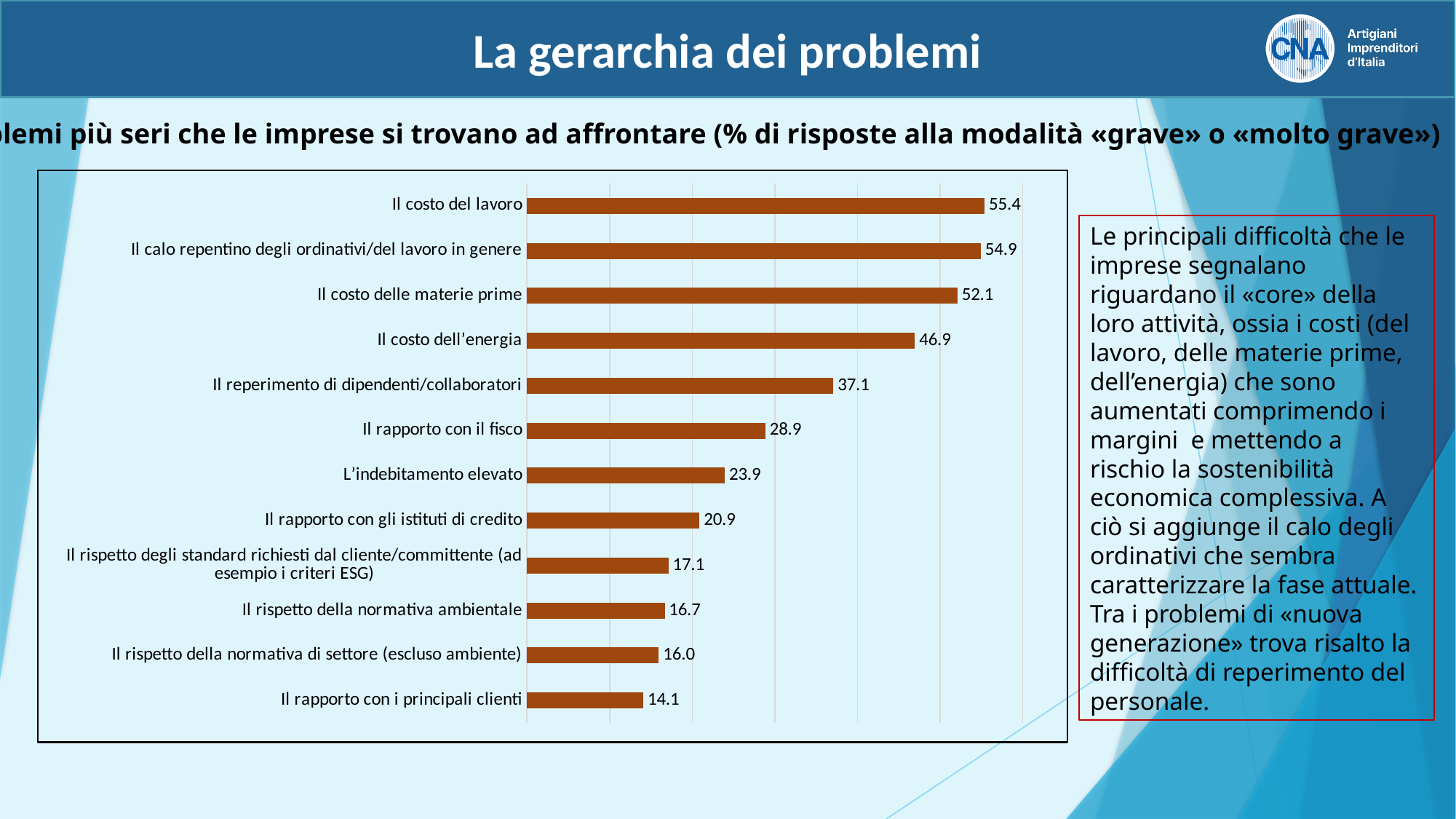
What is the difference between the values for "L'indebitamento elevato" and "Il rapporto con gli istituti di credito"? 3.0 Which is larger, the value for "Il costo dell'energia" or the value for "Il reperimento di dipendenti/collaboratori"? Il costo dell'energia What kind of chart is shown on the slide? Bar chart What is the difference between the values for "Il costo del lavoro" and "Il costo delle materie prime"? 3.3 What colour are the bars in the chart? Brown How many categories are shown in the chart? 12 What is the value for "Il rapporto con il fisco"? 28.9 What is the value for "Il rispetto della normativa ambientale"? 16.7 Which category has the lowest value? Il rapporto con i principali clienti Which category has the highest value? Il costo del lavoro What is the value for "Il costo dell'energia"? 46.9 What is the value for "Il reperimento di dipendenti/collaboratori"? 37.1